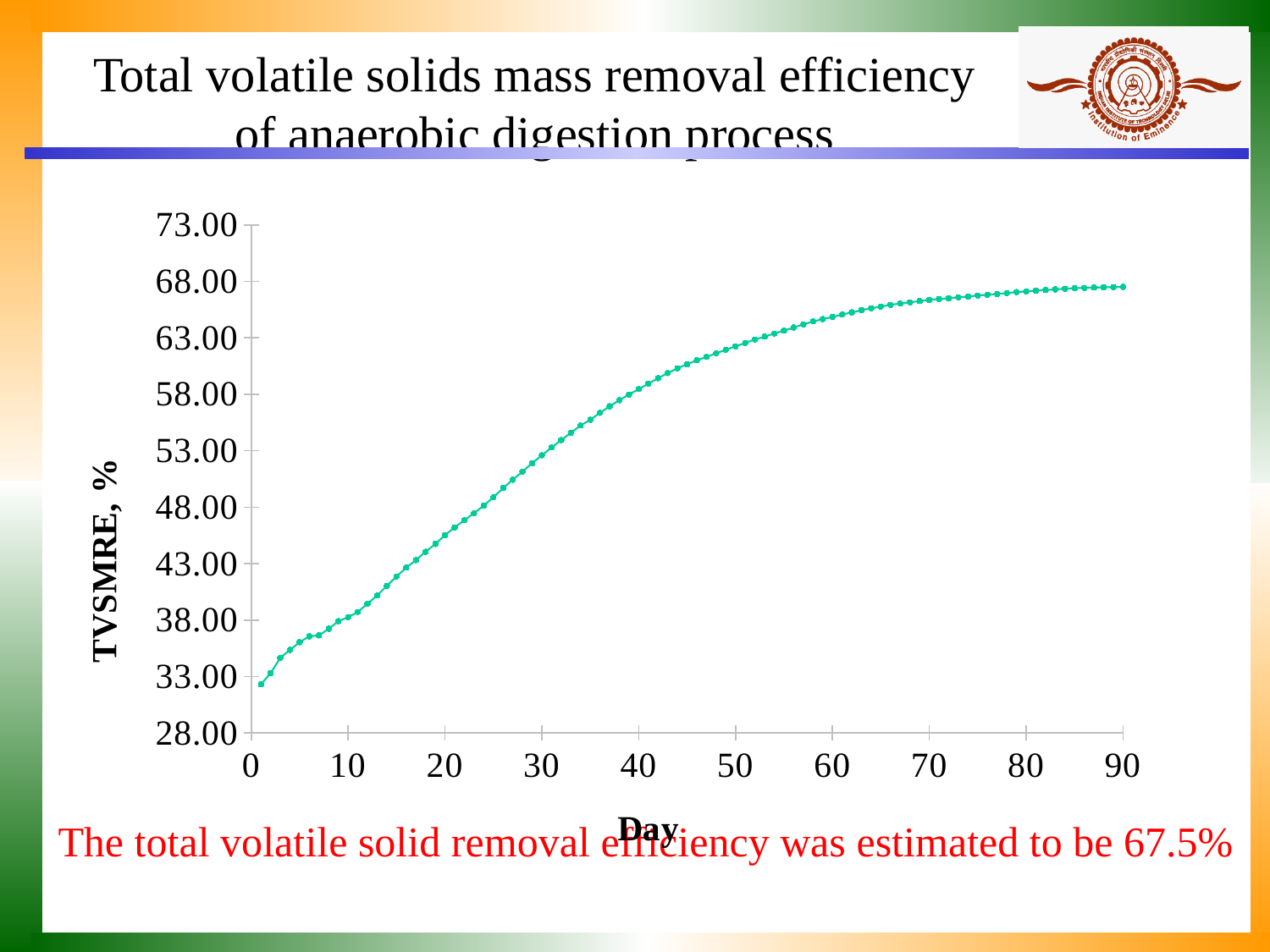
Is the value for TVSMRE at day 30 greater or less than 48.00? greater Which is larger, the TVSMRE value at day 60 or at day 20? day 60 What is the label on the y axis of the chart? TVSMRE, % Is the value for TVSMRE at day 70 greater or less than 68.00? less Is the value for TVSMRE at day 20 greater or less than 48.00? less At which end of the Day axis does the TVSMRE curve reach its lowest value? day 1 (the start) What is the label on the x axis of the chart? Day What kind of chart is shown on the slide? line chart Do the TVSMRE values rise or fall as Day increases along the x axis? rise